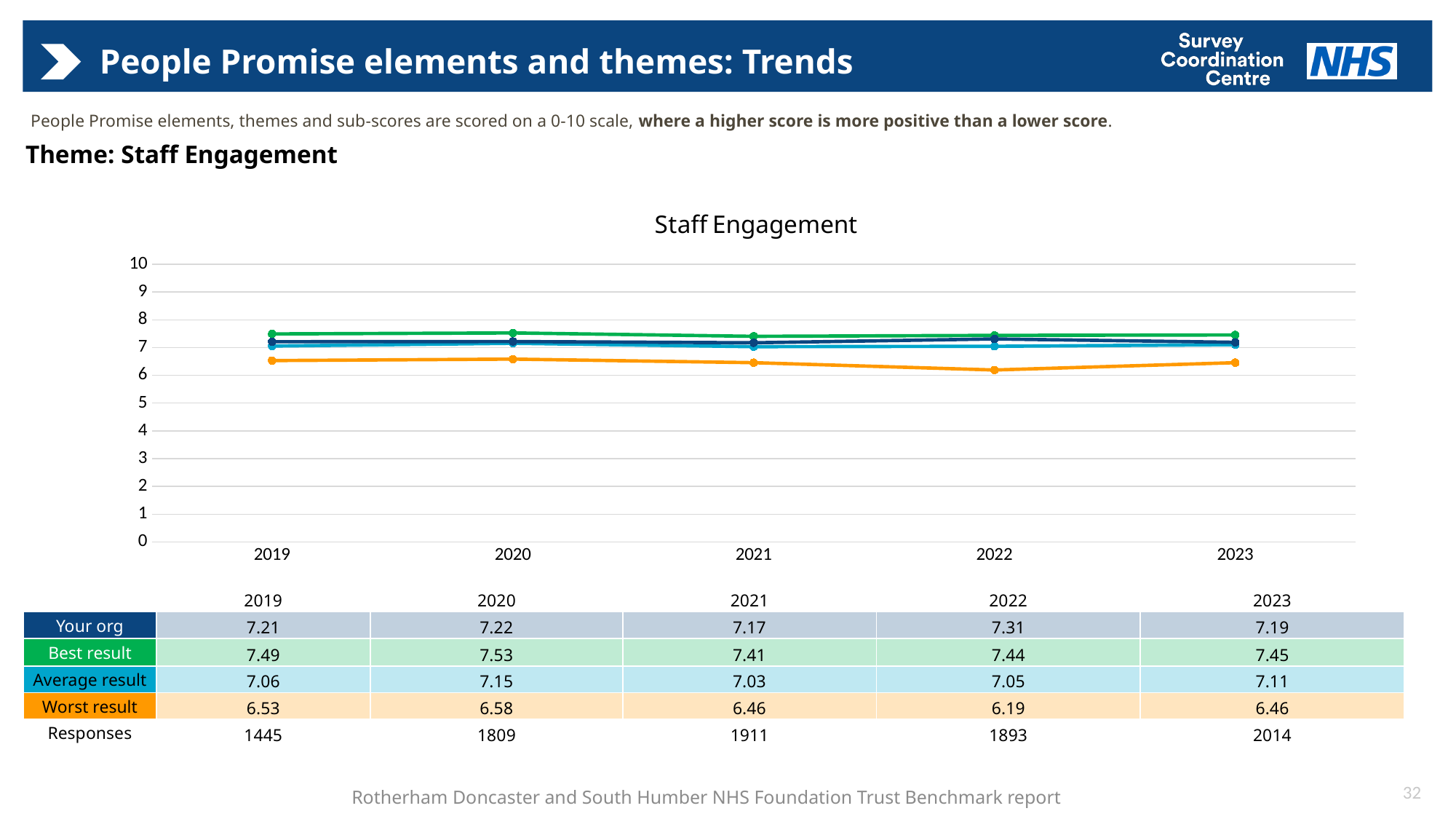
What is the difference between the 'Best result' and 'Worst result' scores in 2021? 0.95 What is the 'Worst result' score for Staff Engagement in 2019? 6.53 What is the 'Your org' score for Staff Engagement in 2022? 7.31 What is the 'Best result' score for Staff Engagement in 2020? 7.53 What is the 'Average result' score for Staff Engagement in 2023? 7.11 In which year was the 'Your org' score highest? 2022 In which year was the 'Worst result' score lowest? 2022 What kind of chart is the Staff Engagement chart? Line chart How many years are shown on the x axis of the Staff Engagement chart? 5 How many series are plotted on the Staff Engagement chart? 4 Which is larger in 2020: the 'Your org' score or the 'Average result' score? Your org Is the 'Worst result' value for 2022 greater or less than 7? less